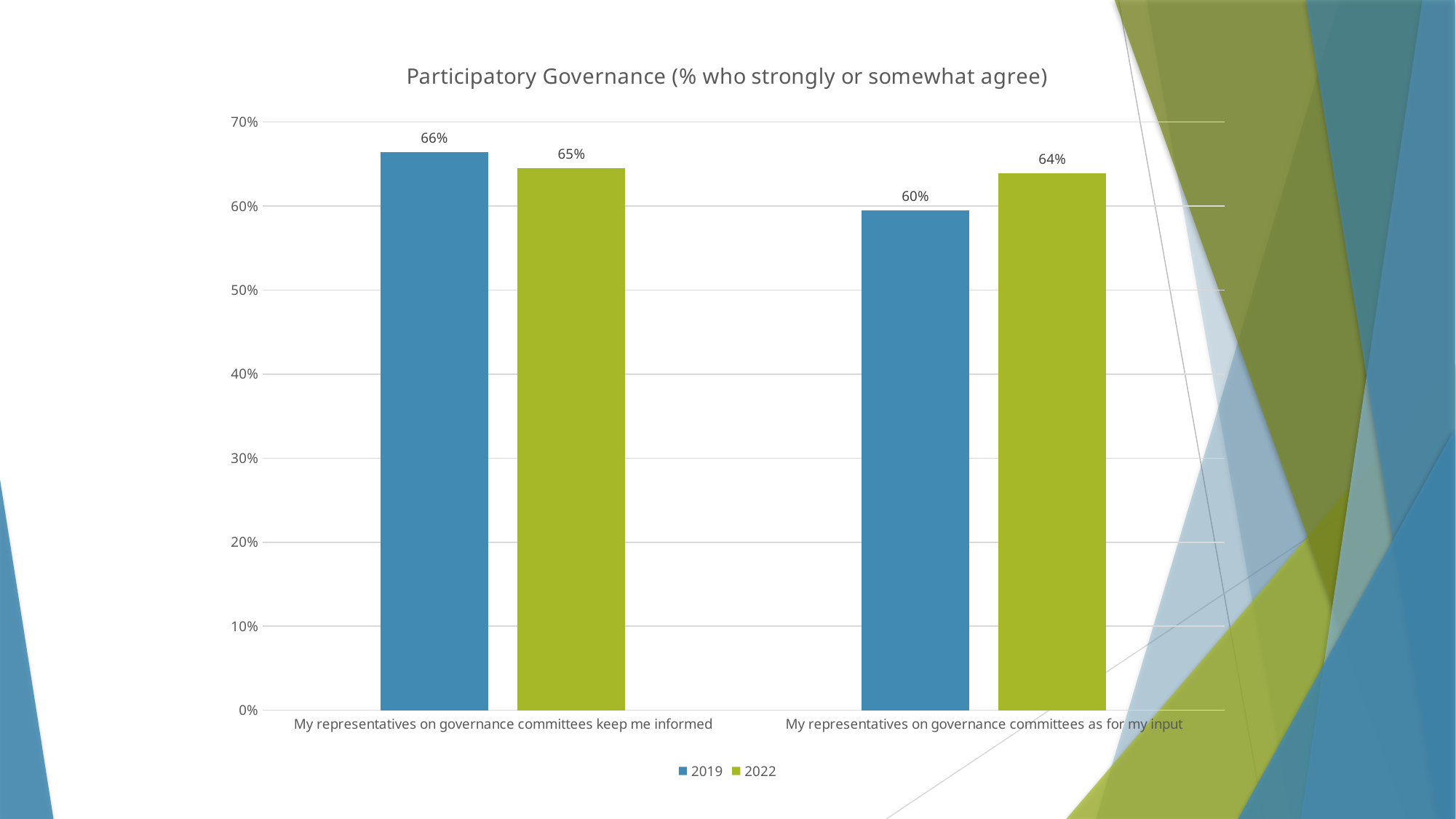
What kind of chart is shown on the slide? Bar chart How many series does the legend list? 2 What is the 2019 value for "My representatives on governance committees keep me informed"? 66% What is the 2022 value for "My representatives on governance committees as for my input"? 64% What is the difference between the 2019 and 2022 values for "My representatives on governance committees keep me informed"? 1% What is the 2022 value for "My representatives on governance committees keep me informed"? 65% Which series has the higher value for "My representatives on governance committees as for my input", 2019 or 2022? 2022 Which bar has the lowest value on the chart? 2019, My representatives on governance committees as for my input What is the difference between the 2022 and 2019 values for "My representatives on governance committees as for my input"? 4% Which bar has the highest value on the chart? 2019, My representatives on governance committees keep me informed What is the title of the chart? Participatory Governance (% who strongly or somewhat agree) What is the 2019 value for "My representatives on governance committees as for my input"? 60%